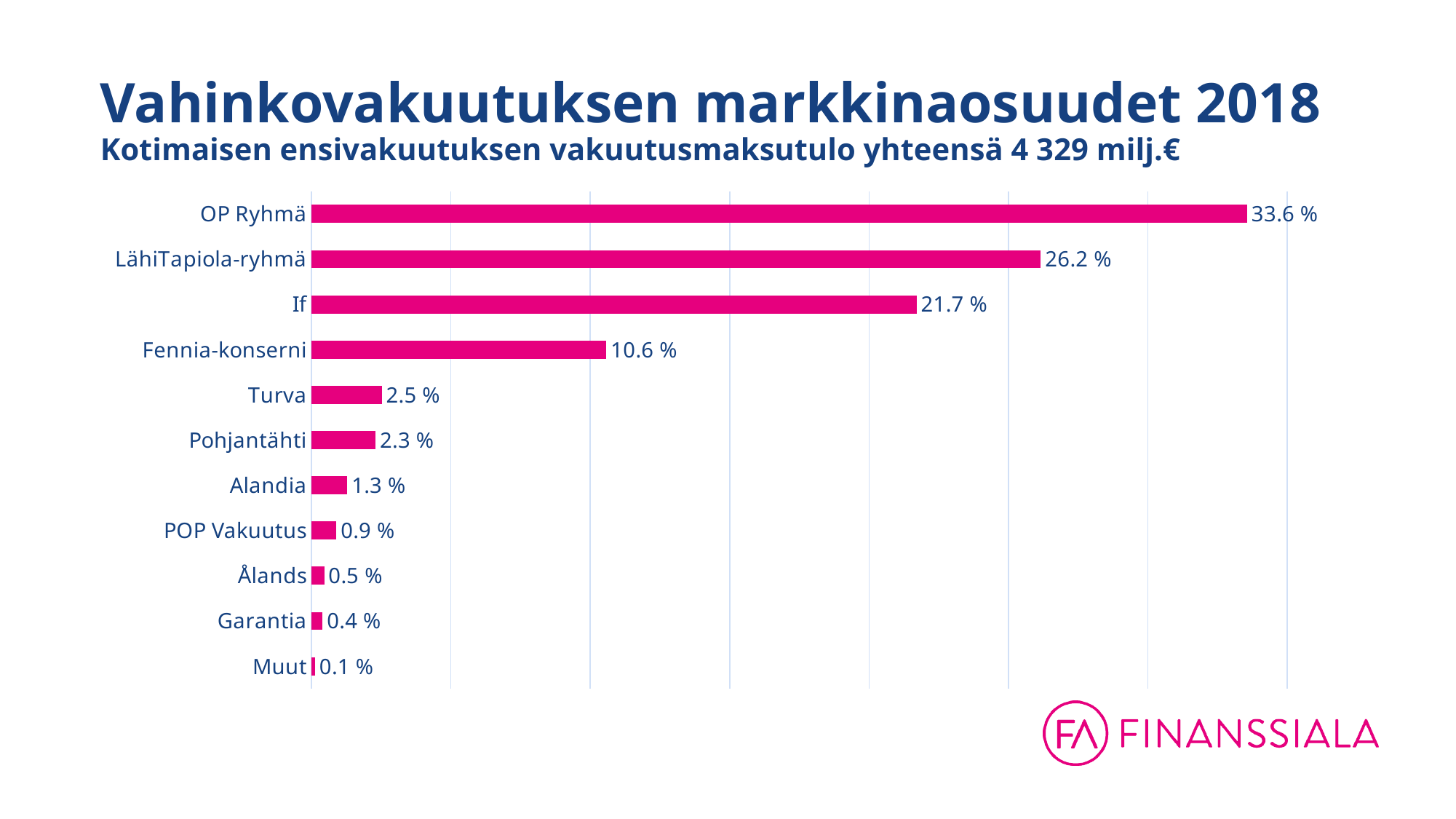
What is the market share shown for Fennia-konserni? 10.6 % Which has a larger market share, Turva or Alandia? Turva How many categories are shown in the chart? 11 What is the difference between the market shares of If and Fennia-konserni? 11.1 % What is the difference between the market shares of OP Ryhmä and LähiTapiola-ryhmä? 7.4 % Which category has the lowest market share? Muut What is the market share shown for Pohjantähti? 2.3 % What is the market share shown for OP Ryhmä? 33.6 % What is the title of the chart on the slide? Vahinkovakuutuksen markkinaosuudet 2018 What kind of chart is shown on the slide? Bar chart What is the market share shown for Ålands? 0.5 % Which category has the highest market share? OP Ryhmä